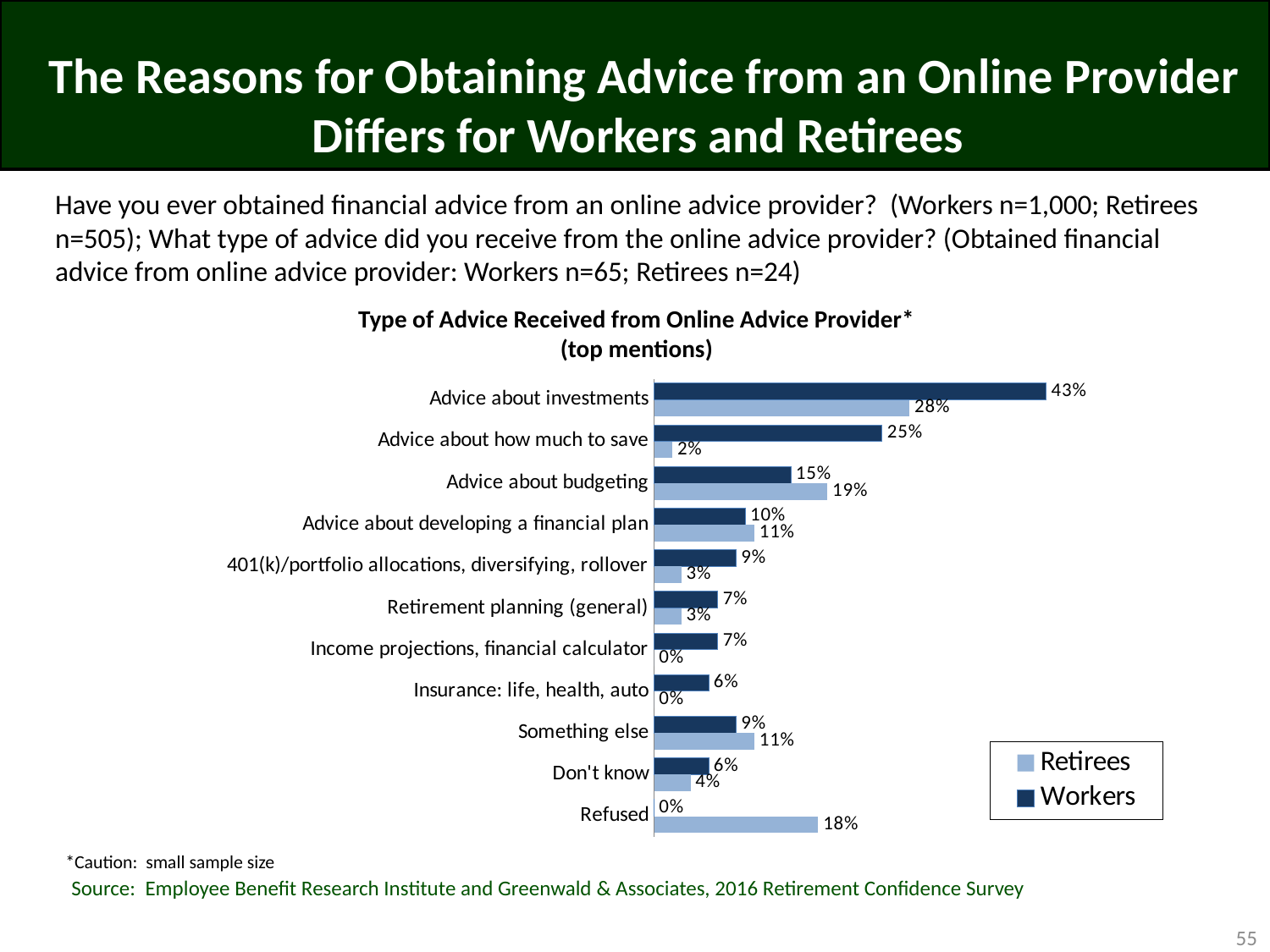
Which series is shown in the darker blue colour? Workers Which type of advice has the highest value for Workers? Advice about investments What percentage of Retirees received advice about how much to save? 2% What is the difference between the Workers and Retirees values for advice about investments? 15 percentage points What is the difference between the Workers and Retirees values for advice about how much to save? 23 percentage points For advice about budgeting, which group has the larger value, Workers or Retirees? Retirees How many series does the legend list? 2 What kind of chart is shown on the slide? Bar chart Which category has the lowest value for Workers? Refused What percentage of Retirees refused to answer what type of advice they received? 18% How many types of advice categories are listed on the chart? 11 What percentage of Workers received advice about investments from an online advice provider? 43%